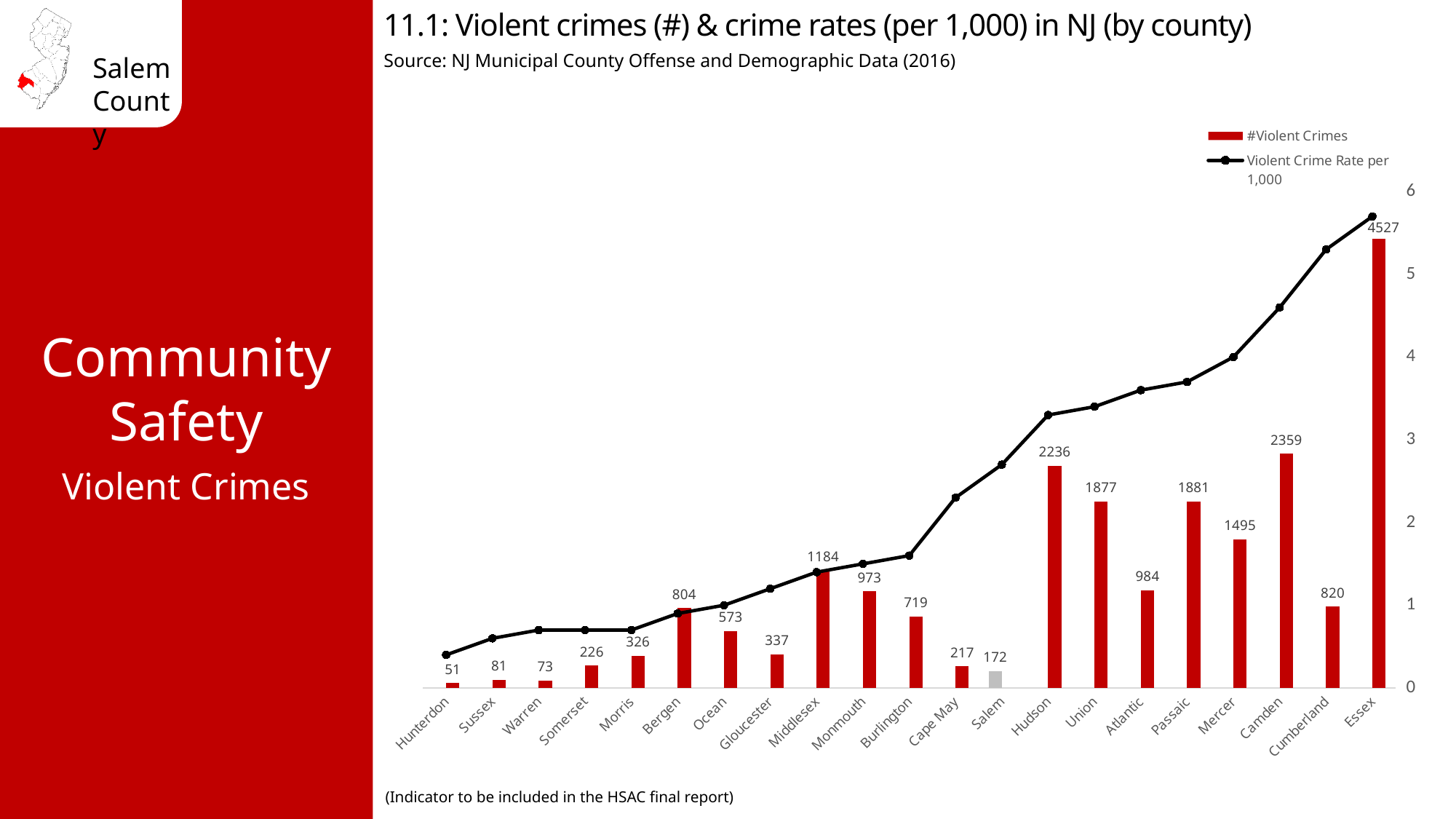
What is the number of violent crimes for Essex? 4527 Is the violent crime rate per 1,000 for Salem greater or less than 2? greater How many series does the legend list? 2 What is the source cited for the chart data? NJ Municipal County Offense and Demographic Data (2016) What is the difference in the number of violent crimes between Camden and Hudson? 123 How many violent crimes are shown for Salem County? 172 How many counties are shown on the x axis? 21 Which county has more violent crimes, Union or Passaic? Passaic Is the violent crime rate per 1,000 for Hunterdon greater or less than 1? less Which county has the lowest number of violent crimes? Hunterdon Does the violent crime rate per 1,000 line generally rise or fall from Hunterdon to Essex? rise Which county has the highest number of violent crimes? Essex